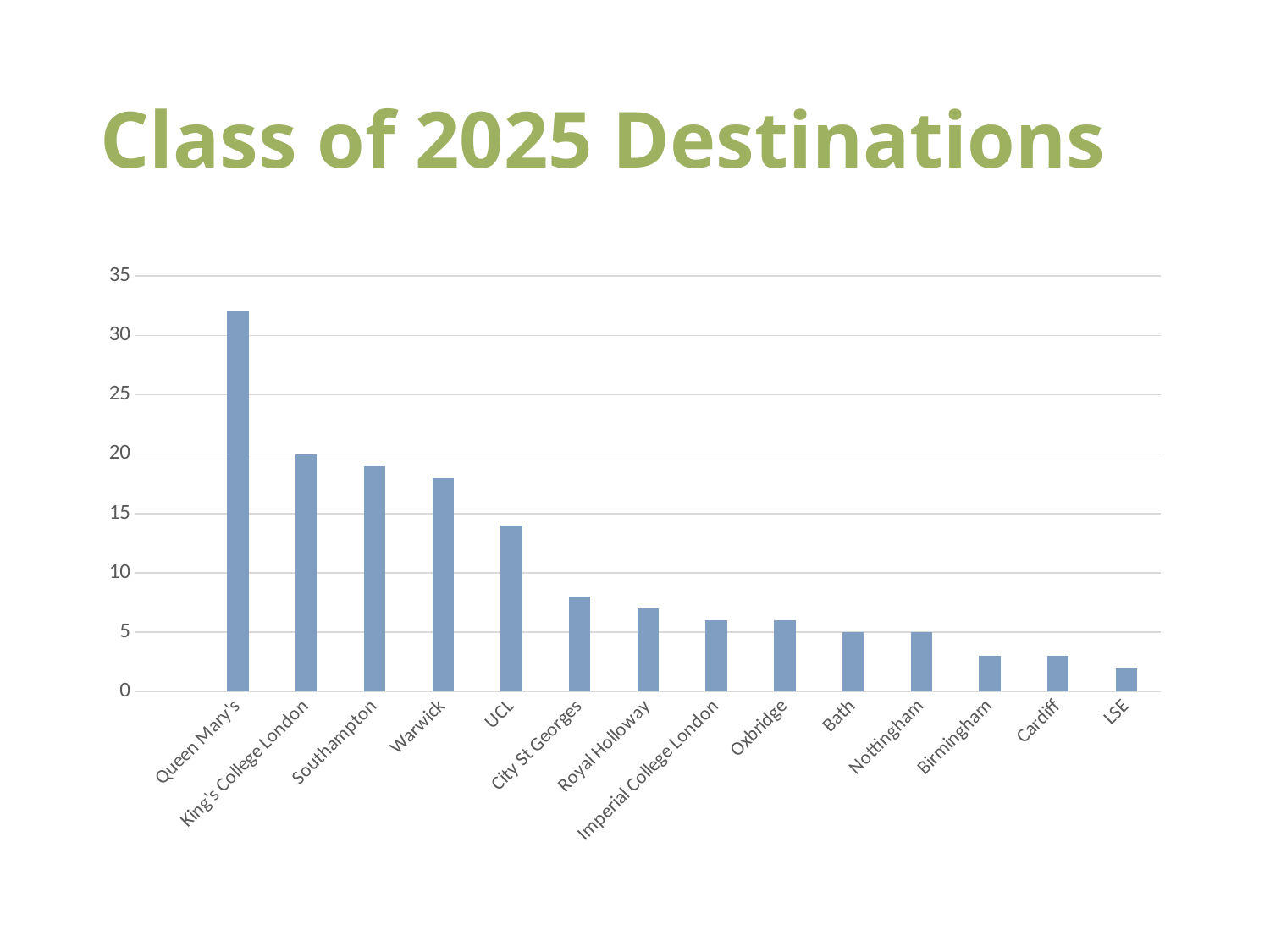
Is the value for UCL greater or less than 15? less How many destinations are shown on the x axis? 14 What is the value for Bath? 5 Is the value for Queen Mary's greater or less than 30? greater What is the value for King's College London? 20 Which destination has the highest value? Queen Mary's Is the value for Southampton greater or less than 15? greater Which is larger, the value for Warwick or the value for City St Georges? Warwick What is the title of the chart? Class of 2025 Destinations Which destination has the lowest value? LSE What type of chart is shown on the slide? Bar chart Do the values generally rise or fall from left to right along the x axis? Fall